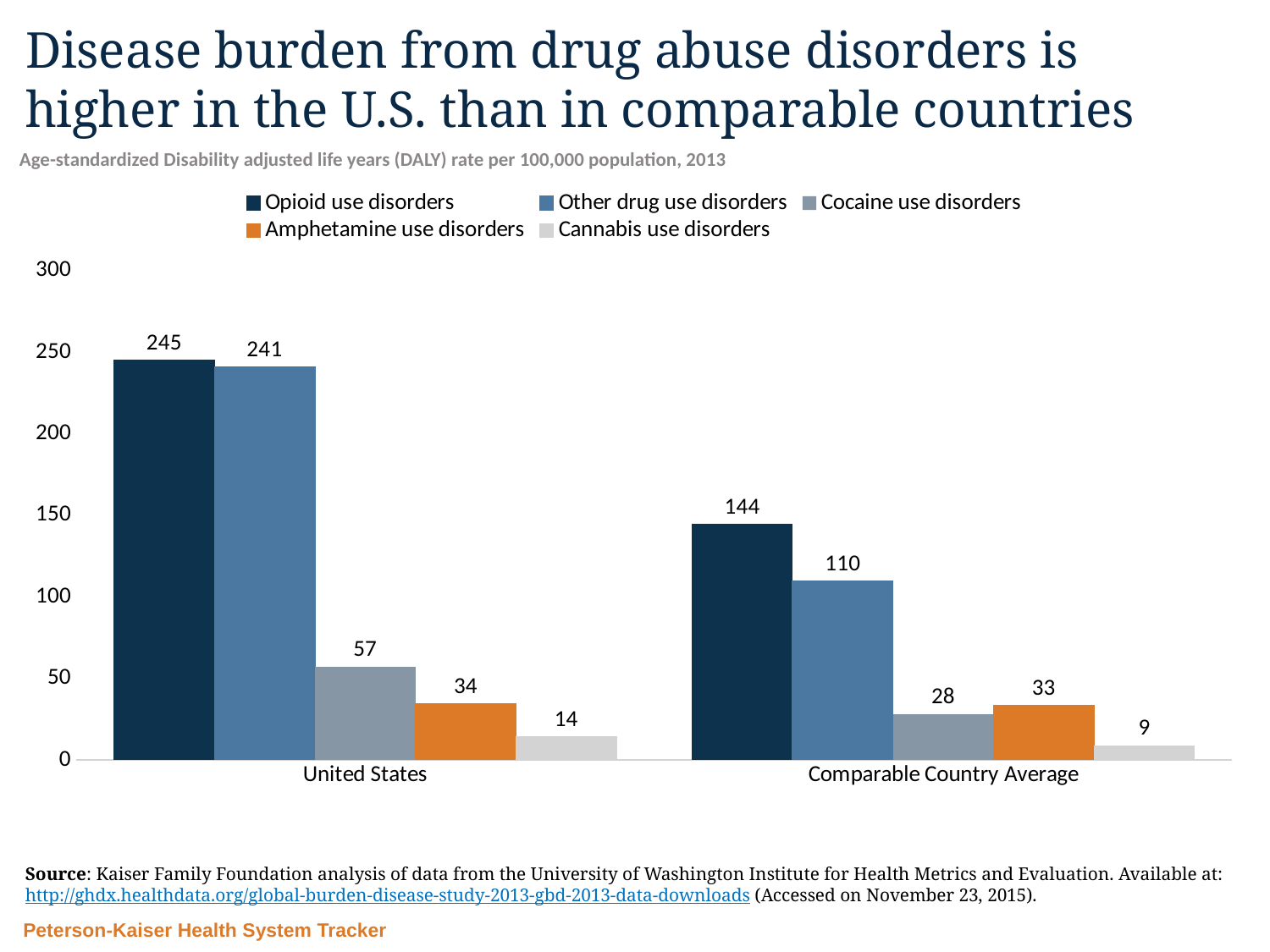
What is the DALY rate for other drug use disorders in the Comparable Country Average? 110 Is the value for other drug use disorders in the United States greater or less than 200? greater How many series does the legend list? 5 What kind of chart is shown on the slide? Bar chart Which disorder has the lowest DALY rate in the United States? Cannabis use disorders What is the DALY rate for cannabis use disorders in the United States? 14 What is the difference between the cocaine use disorders DALY rate in the United States and in the Comparable Country Average? 29 Which is larger: the amphetamine use disorders rate in the United States or in the Comparable Country Average? United States Which disorder has the highest DALY rate in the Comparable Country Average? Opioid use disorders What is the difference between the opioid use disorders DALY rate in the United States and in the Comparable Country Average? 101 How many country categories are shown on the x axis? 2 What is the DALY rate for opioid use disorders in the United States? 245